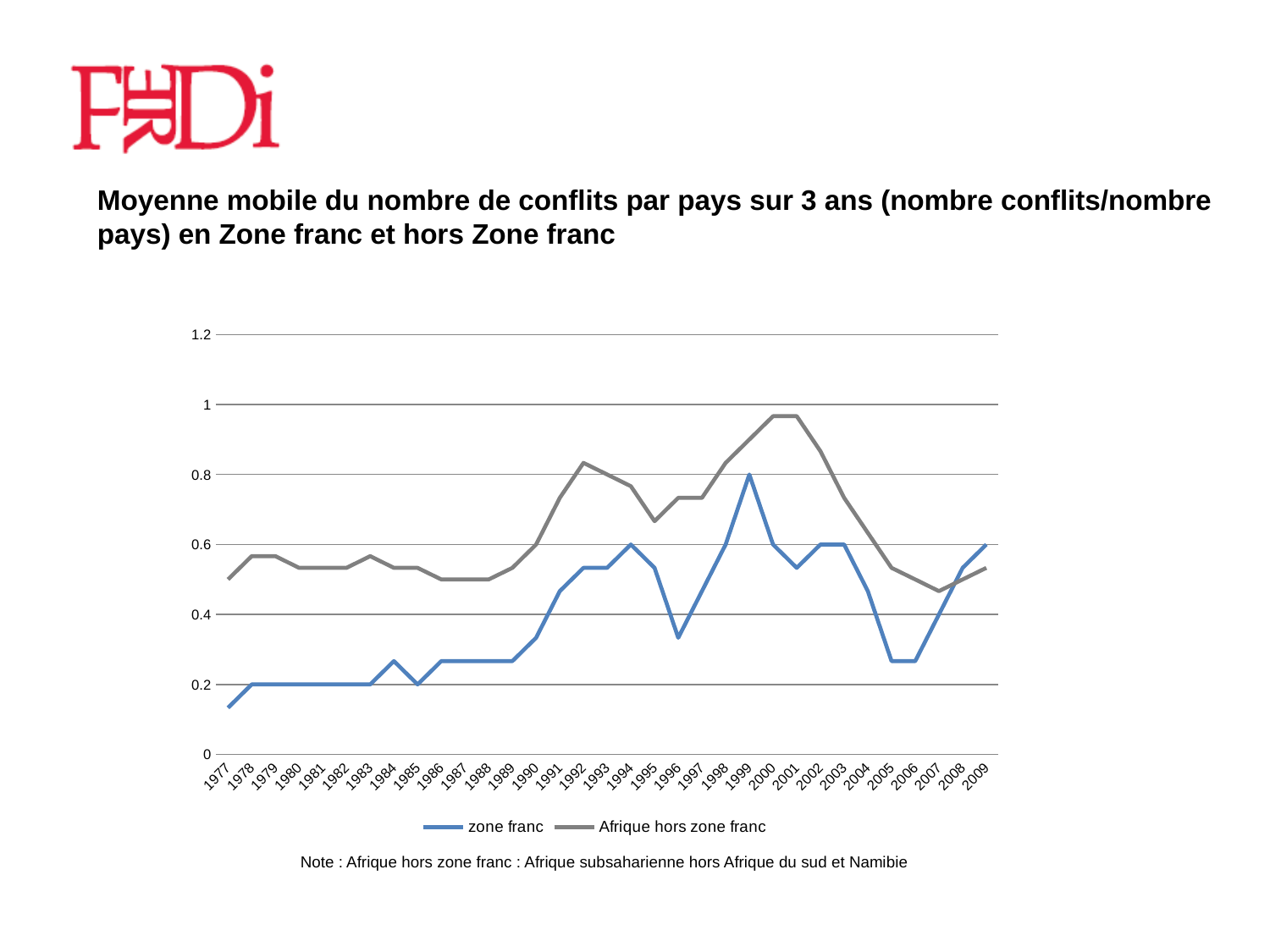
Is the value for zone franc in 1977 greater or less than 0.2? less Is the value for zone franc in 2005 greater or less than 0.4? less In which year does the zone franc series reach its highest value? 1999 What kind of chart is shown on the slide? line chart Does the zone franc series rise or fall between 2006 and 2009? rise How many series does the legend list? 2 What is the first year shown on the x axis? 1977 Which two series are listed in the legend? zone franc; Afrique hors zone franc Is the value for Afrique hors zone franc in 2000 greater or less than 0.8? greater In 2000, which series has the higher value, zone franc or Afrique hors zone franc? Afrique hors zone franc How many years are shown on the x axis? 33 In which year is the zone franc series at its lowest value? 1977